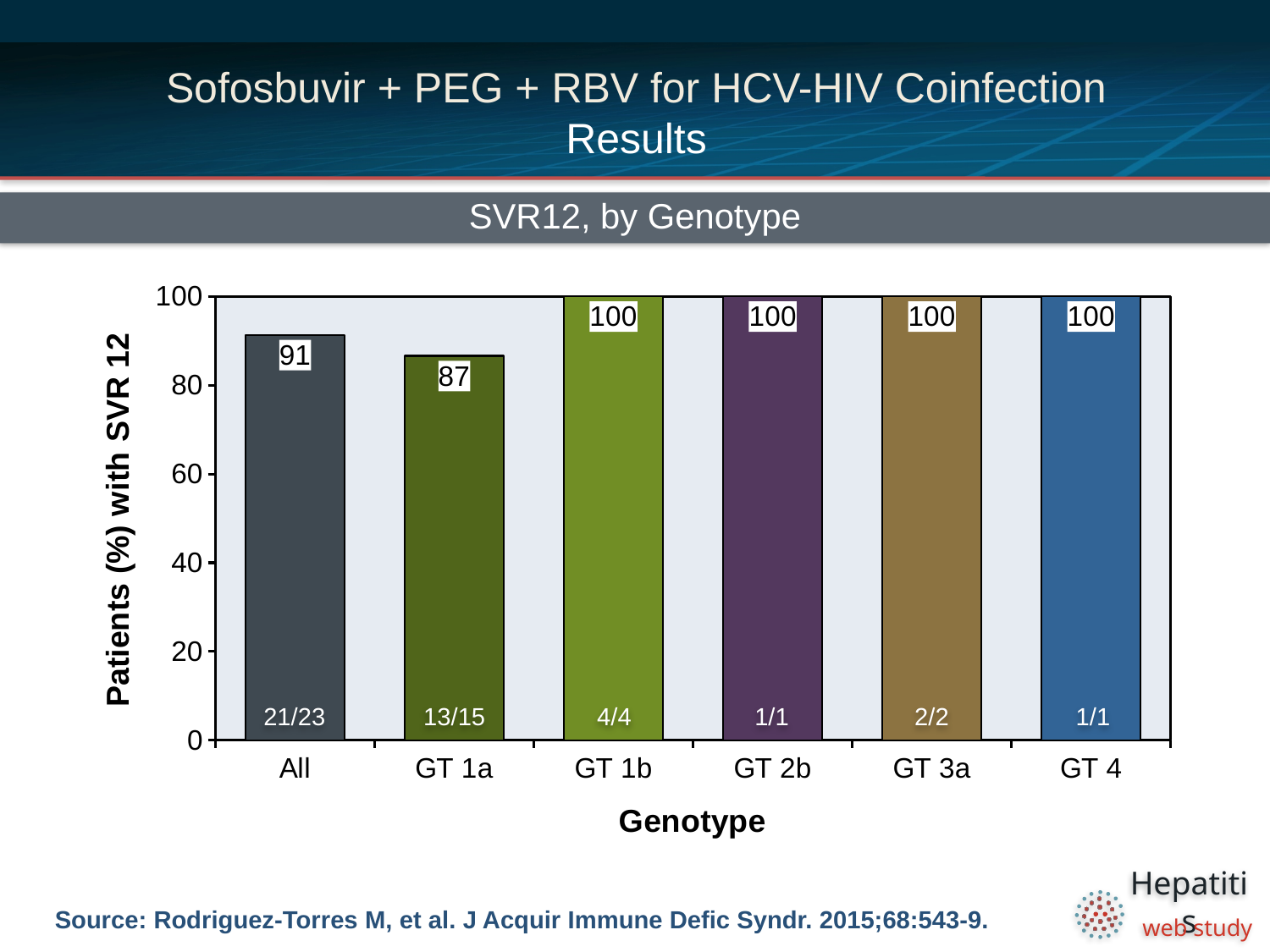
What is the difference between the SVR12 value for GT 1b and the value for GT 1a? 13 Which genotype category has the lowest SVR12 value? GT 1a What is the label of the y axis? Patients (%) with SVR 12 What is the difference between the SVR12 value for All and the value for GT 1a? 4 What fraction of patients is shown at the base of the All bar? 21/23 What fraction of patients is shown at the base of the GT 1a bar? 13/15 How many categories are shown on the x axis? 6 What kind of chart is shown on the slide? Bar chart What is the SVR12 value for GT 1a? 87 Which is larger, the SVR12 value for All or for GT 1a? All What is the SVR12 value for the All group? 91 Is the SVR12 value for GT 1a greater or less than 80? greater